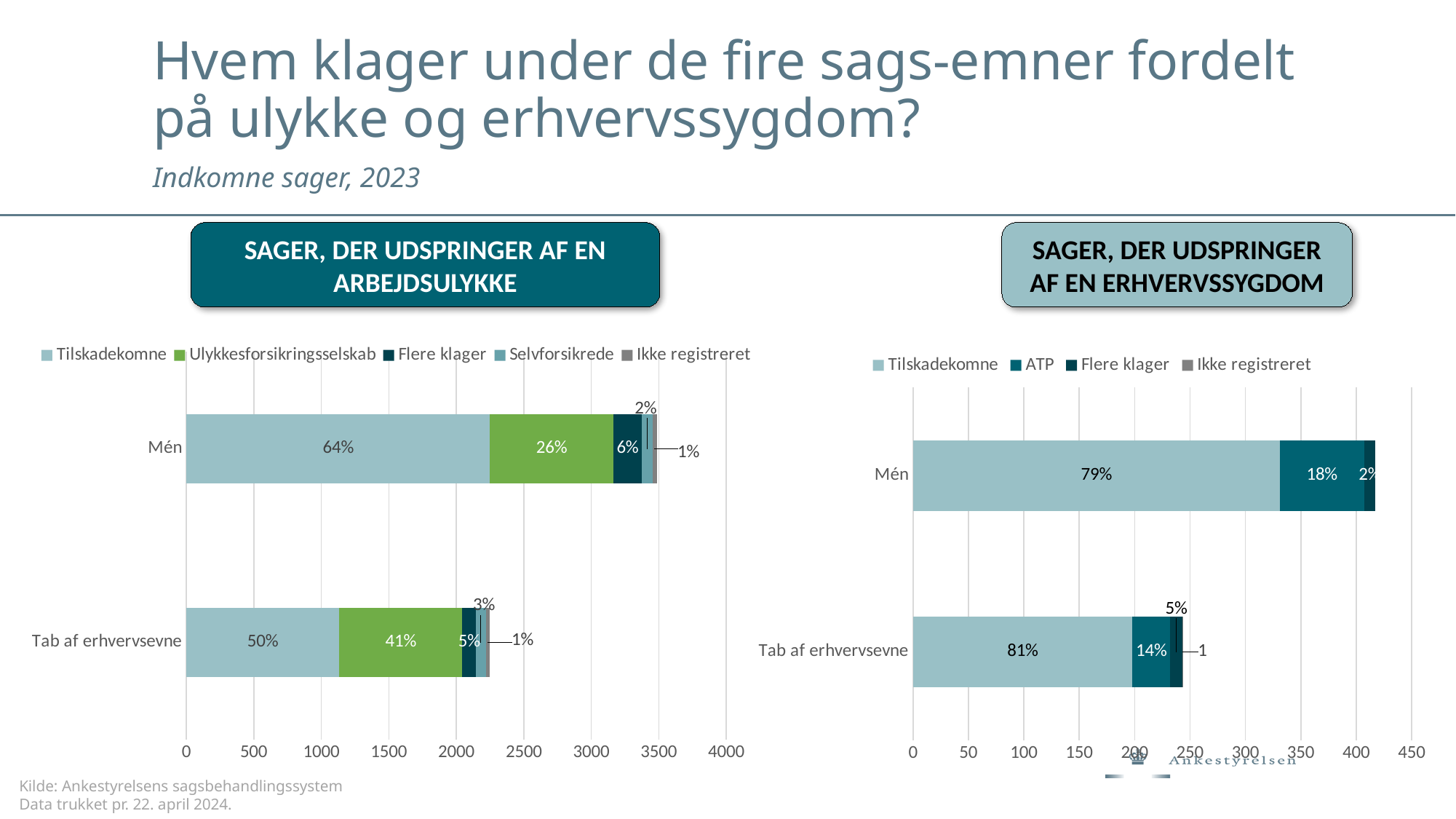
How many categories are shown on the y axis of the chart 'Sager, der udspringer af en erhvervssygdom'? 2 In the chart 'Sager, der udspringer af en erhvervssygdom', what percentage of the Tab af erhvervsevne bar is Tilskadekomne? 81% In the chart 'Sager, der udspringer af en arbejdsulykke', what is the difference in percentage points between the Tilskadekomne share for Mén and for Tab af erhvervsevne? 14 percentage points In the chart 'Sager, der udspringer af en erhvervssygdom', is the total length of the Mén bar greater or less than 400? greater What kind of chart is 'Sager, der udspringer af en arbejdsulykke'? Stacked bar chart In the chart 'Sager, der udspringer af en arbejdsulykke', what percentage of the Mén bar is Tilskadekomne? 64% In the chart 'Sager, der udspringer af en arbejdsulykke', what percentage of the Tab af erhvervsevne bar is Ulykkesforsikringsselskab? 41% In the chart 'Sager, der udspringer af en arbejdsulykke', is the total length of the Mén bar greater or less than 3000? greater How many series does the legend of the chart 'Sager, der udspringer af en erhvervssygdom' list? 4 In the chart 'Sager, der udspringer af en erhvervssygdom', what percentage of the Mén bar is ATP? 18% In the chart 'Sager, der udspringer af en arbejdsulykke', which category has the longer total bar, Mén or Tab af erhvervsevne? Mén How many series does the legend of the chart 'Sager, der udspringer af en arbejdsulykke' list? 5